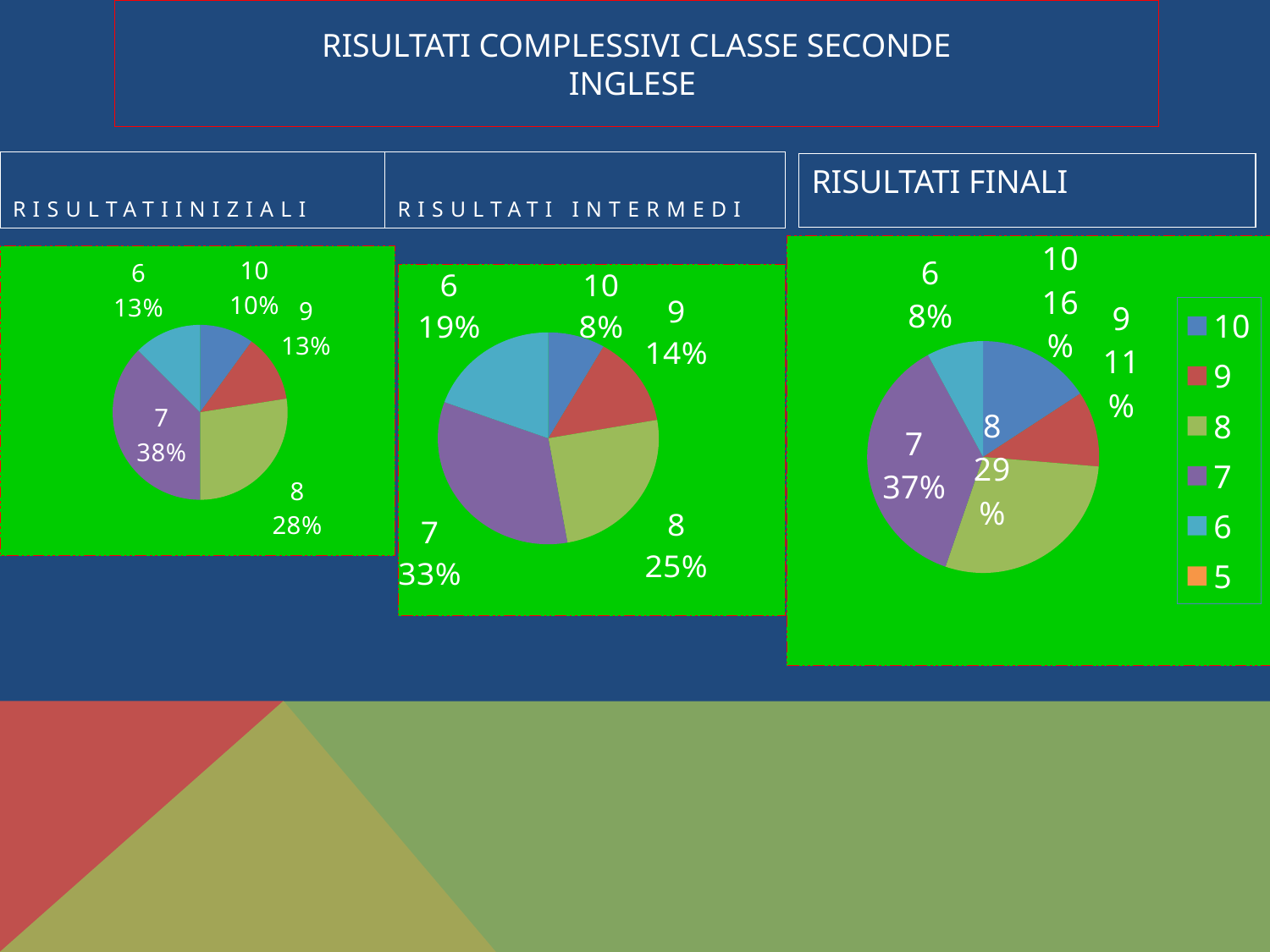
How many entries does the legend of the Risultati Finali chart list? 6 In the Risultati Intermedi pie chart, what share does grade 6 have? 19% What kind of chart is used for Risultati Finali? pie chart In the Risultati Finali pie chart, what is the difference in percentage points between the shares of grade 7 and grade 6? 29 In the Risultati Intermedi pie chart, which grade has the smallest share? 10 In the Risultati Iniziali pie chart, which has the larger share, grade 8 or grade 10? 8 In the Risultati Iniziali pie chart, what share does grade 7 have? 38% In the Risultati Finali pie chart, what share does grade 8 have? 29% In the Risultati Finali pie chart, which grade has the largest share? 7 In the Risultati Finali pie chart, what share does grade 10 have? 16% In the Risultati Iniziali pie chart, what share does grade 8 have? 28% In the Risultati Intermedi pie chart, what share does grade 10 have? 8%